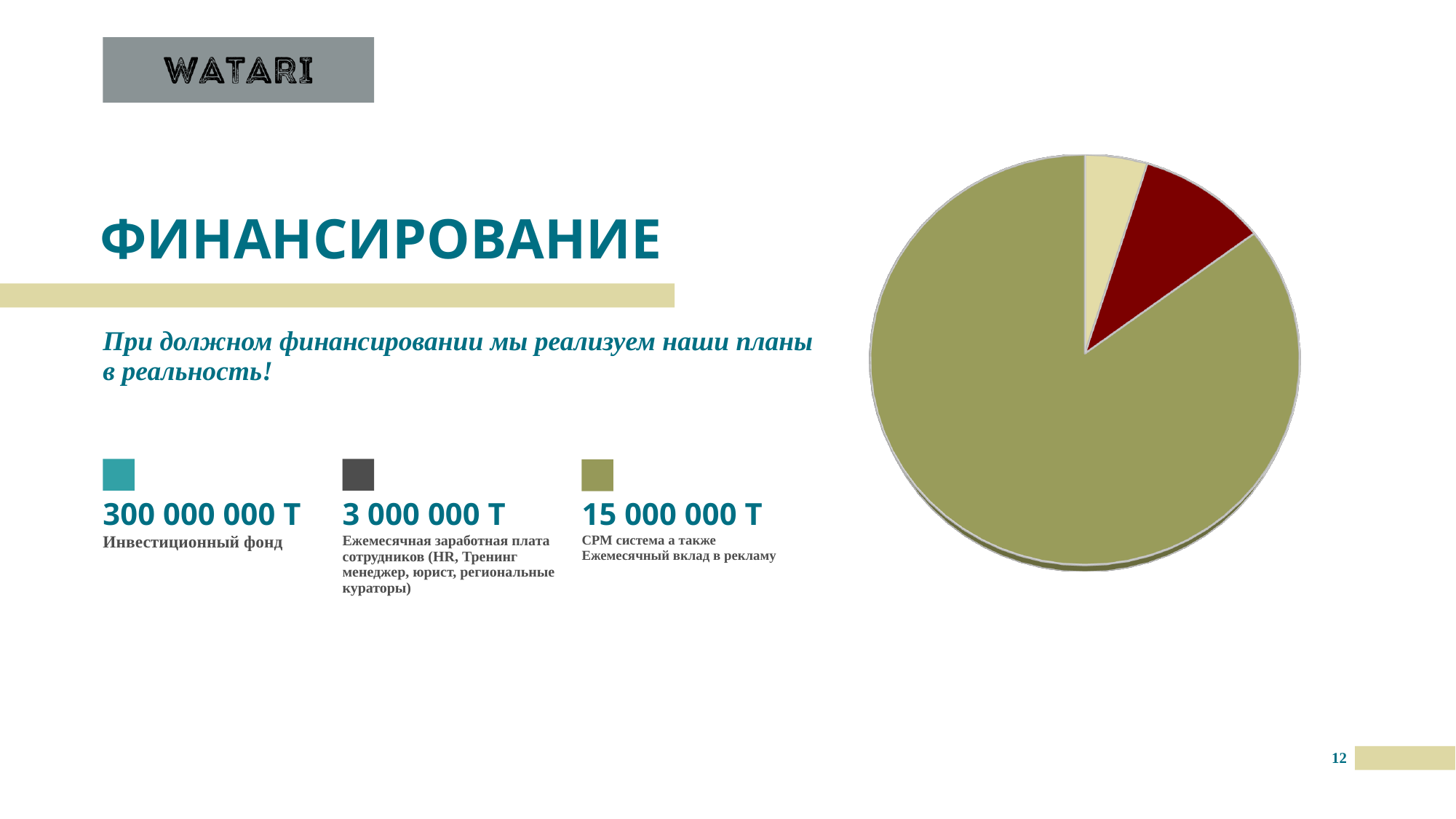
What kind of chart is shown on the slide? pie chart How many slices does the pie chart have? 3 What is the title of the slide containing the pie chart? ФИНАНСИРОВАНИЕ Is the dark red slice larger or smaller than the pale yellow slice? larger What amount is listed for CPM система а также Ежемесячный вклад в рекламу? 15 000 000 T What amount is listed for Инвестиционный фонд? 300 000 000 T What is the difference between the amount for CPM система а также Ежемесячный вклад в рекламу and the amount for Ежемесячная заработная плата сотрудников? 12 000 000 T Which colour slice is the largest in the pie chart? olive green Which colour slice is the smallest in the pie chart? pale yellow Which listed amount is larger: Инвестиционный фонд or CPM система а также Ежемесячный вклад в рекламу? Инвестиционный фонд What amount is listed for Ежемесячная заработная плата сотрудников? 3 000 000 T Does the olive green slice take up more or less than half of the pie chart? more